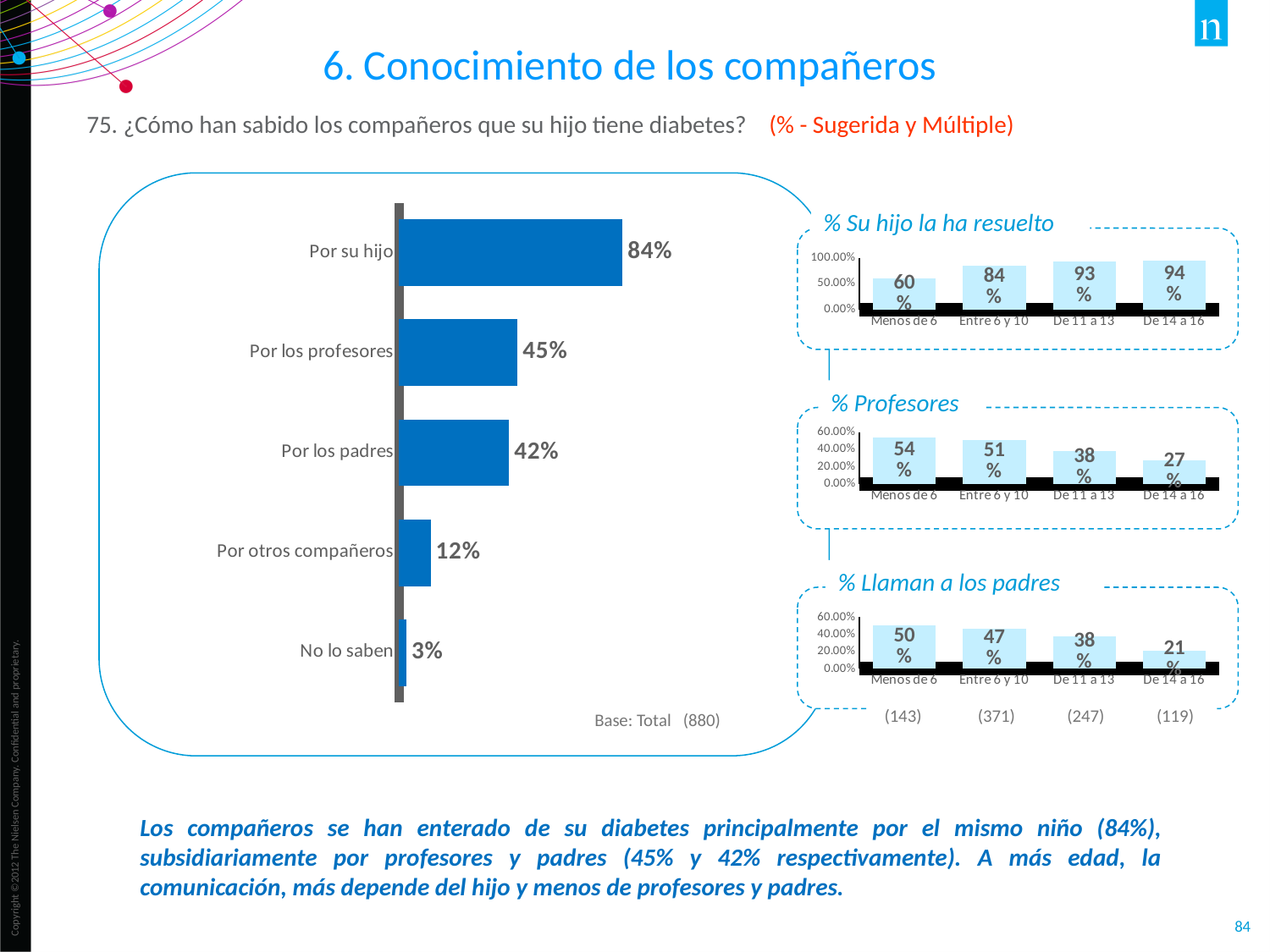
In the main bar chart on the left, what is the difference between 'Por su hijo' and 'Por los padres'? 42% In the '% Su hijo la ha resuelto' chart, what is the value for 'Entre 6 y 10'? 84% In the '% Su hijo la ha resuelto' chart, do the values rise or fall from 'Menos de 6' to 'De 14 a 16'? Rise In the main bar chart on the left, which category has the lowest value? No lo saben In the '% Llaman a los padres' chart, what is the value for 'De 11 a 13'? 38% How many categories does the main bar chart on the left show? 5 In the '% Profesores' chart, which age group has the lowest value? De 14 a 16 In the main bar chart on the left, what is the value for 'Por los profesores'? 45% What kind of chart is the main chart on the left? Bar chart In the main bar chart on the left, which category has the highest value? Por su hijo In the '% Llaman a los padres' chart, which is larger: 'Menos de 6' or 'De 14 a 16'? Menos de 6 In the '% Profesores' chart, what is the difference between 'Menos de 6' and 'De 11 a 13'? 16%